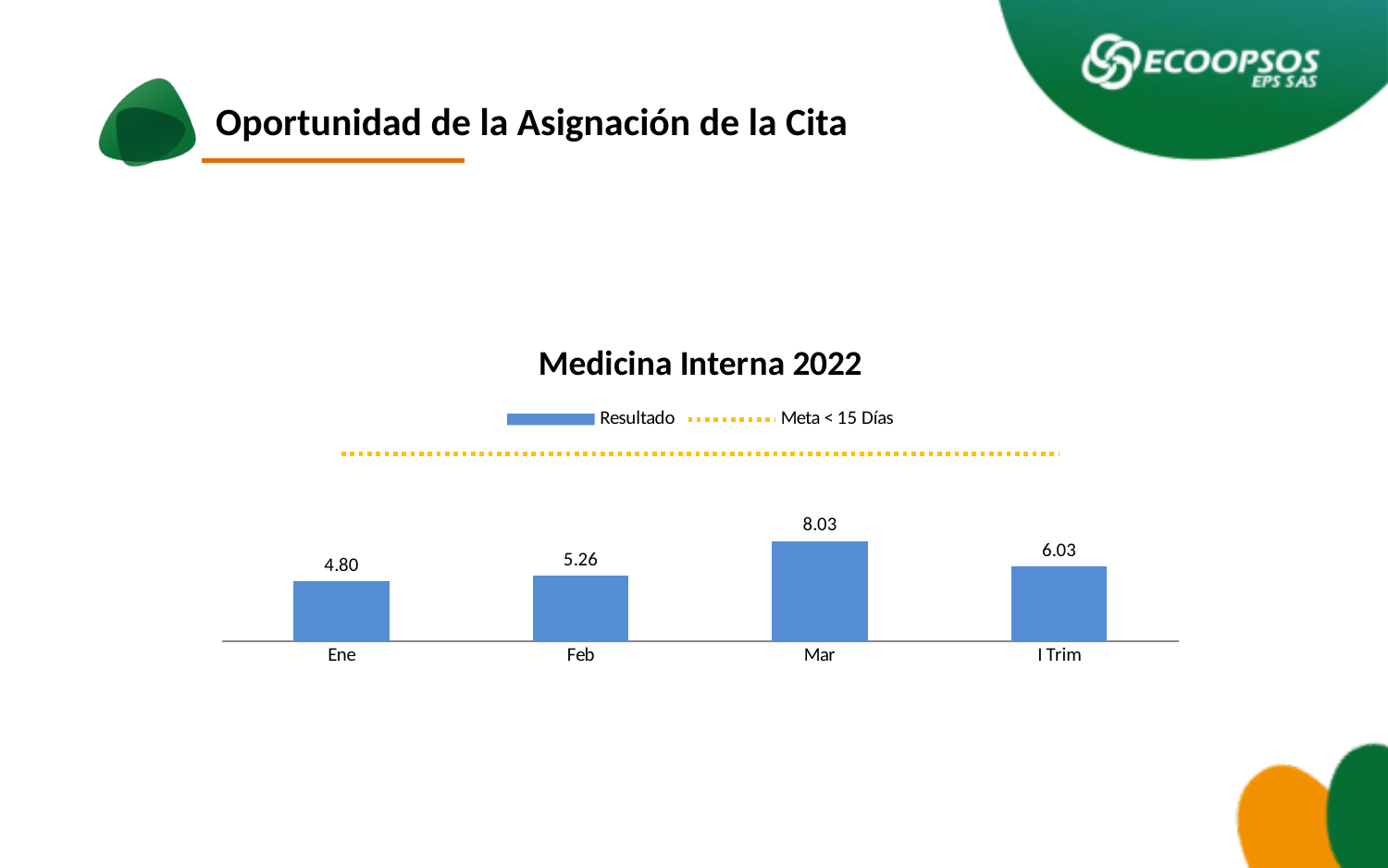
Do the Resultado values rise or fall from Ene to Mar? Rise How many categories are shown on the x axis? 4 Which category has the lowest Resultado value? Ene What is the Resultado value for Mar? 8.03 Which is larger, the Resultado value for Feb or for I Trim? I Trim What is the title of the chart? Medicina Interna 2022 What is the Resultado value for I Trim? 6.03 How many series does the legend list? 2 What is the difference between the Resultado values for Mar and Feb? 2.77 Which category has the highest Resultado value? Mar What kind of chart is shown on the slide? Combination bar and line chart What is the Resultado value for Ene? 4.80